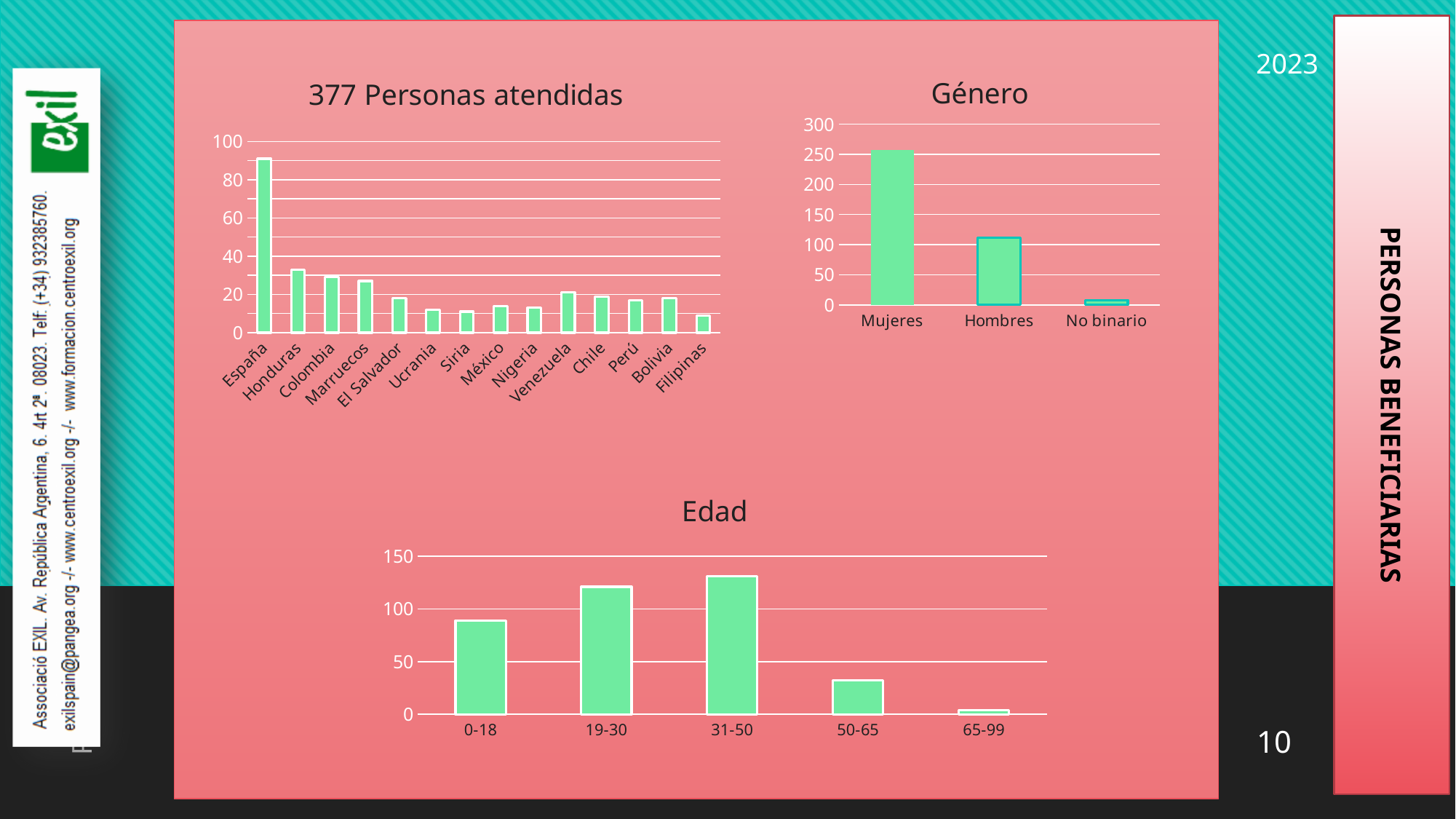
In the 'Género' chart, which category has the lowest value? No binario In the 'Edad' chart, which age group has the highest value? 31-50 In the '377 Personas atendidas' chart, is the value for España greater or less than 80? greater In the 'Edad' chart, is the value for 0-18 greater or less than 100? less In the 'Género' chart, is the value for Mujeres greater or less than 200? greater In the '377 Personas atendidas' chart, which is larger, the value for Honduras or the value for Ucrania? Honduras In the '377 Personas atendidas' chart, how many countries are shown on the x axis? 14 In the '377 Personas atendidas' chart, which country has the highest bar? España In the 'Género' chart, which category has the highest value? Mujeres What type of chart is the 'Edad' chart? Bar chart